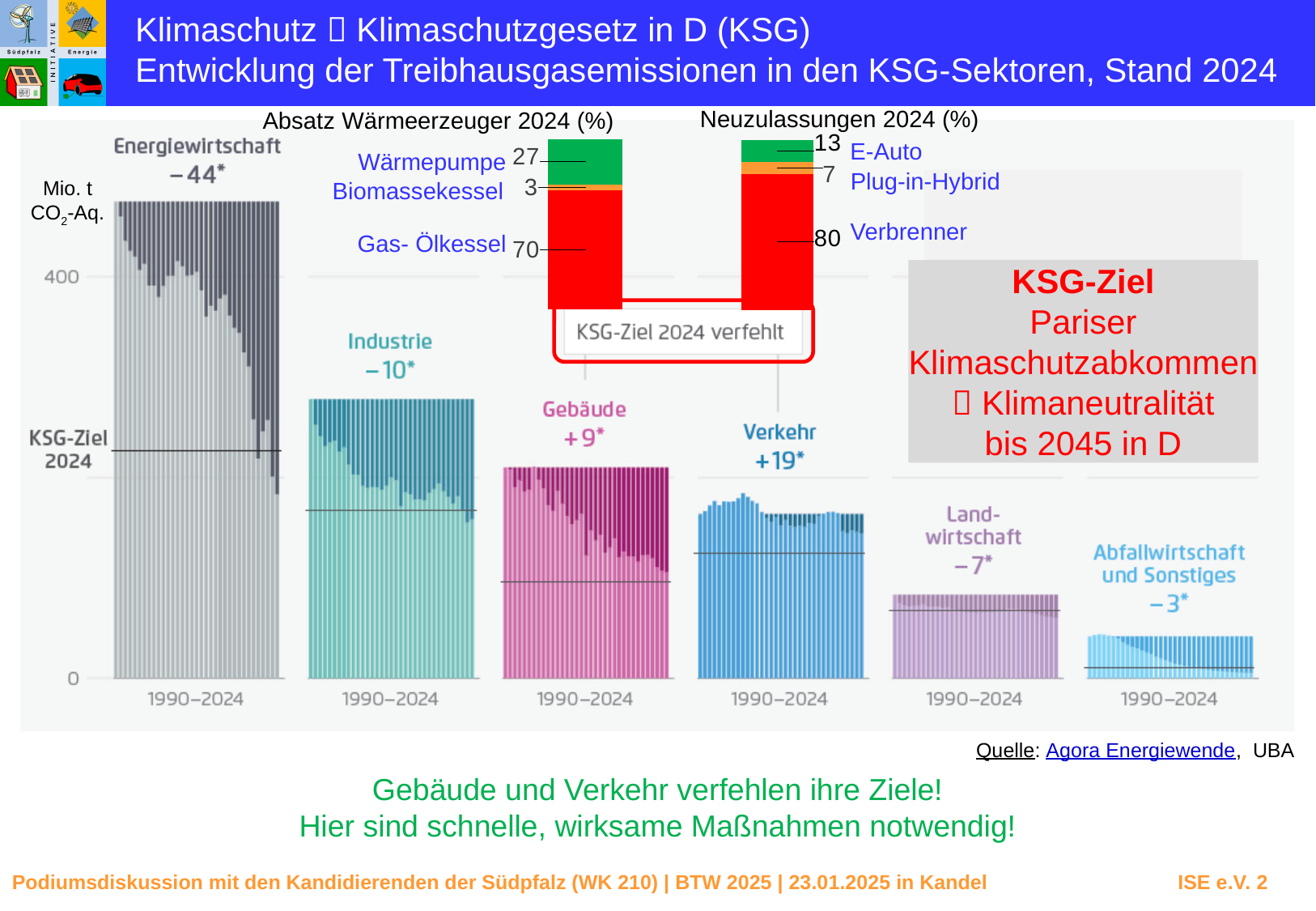
In the emissions chart, what percentage change is shown for the Energiewirtschaft sector? −44* In the emissions chart, which sector shows the largest percentage increase? Verkehr In the 'Absatz Wärmeerzeuger 2024 (%)' bar, what share is shown for Wärmepumpe? 27 In the 'Neuzulassungen 2024 (%)' bar, what share is shown for Verbrenner? 80 In the 'Neuzulassungen 2024 (%)' bar, what is the total of E-Auto, Plug-in-Hybrid and Verbrenner? 100 In the 'Absatz Wärmeerzeuger 2024 (%)' bar, how much larger is the Gas-/Ölkessel share than the Wärmepumpe share? 43 How many KSG sectors are shown in the emissions chart? 6 In the emissions chart, what percentage change is shown for the Verkehr sector? +19* What kind of chart is used to show the emissions development of the KSG sectors? Bar chart What unit is given on the y axis of the emissions chart? Mio. t CO2-Äq. In the emissions chart, is the Energiewirtschaft value in 1990 greater or less than 400? greater In the emissions chart, which sector shows the largest percentage decrease? Energiewirtschaft